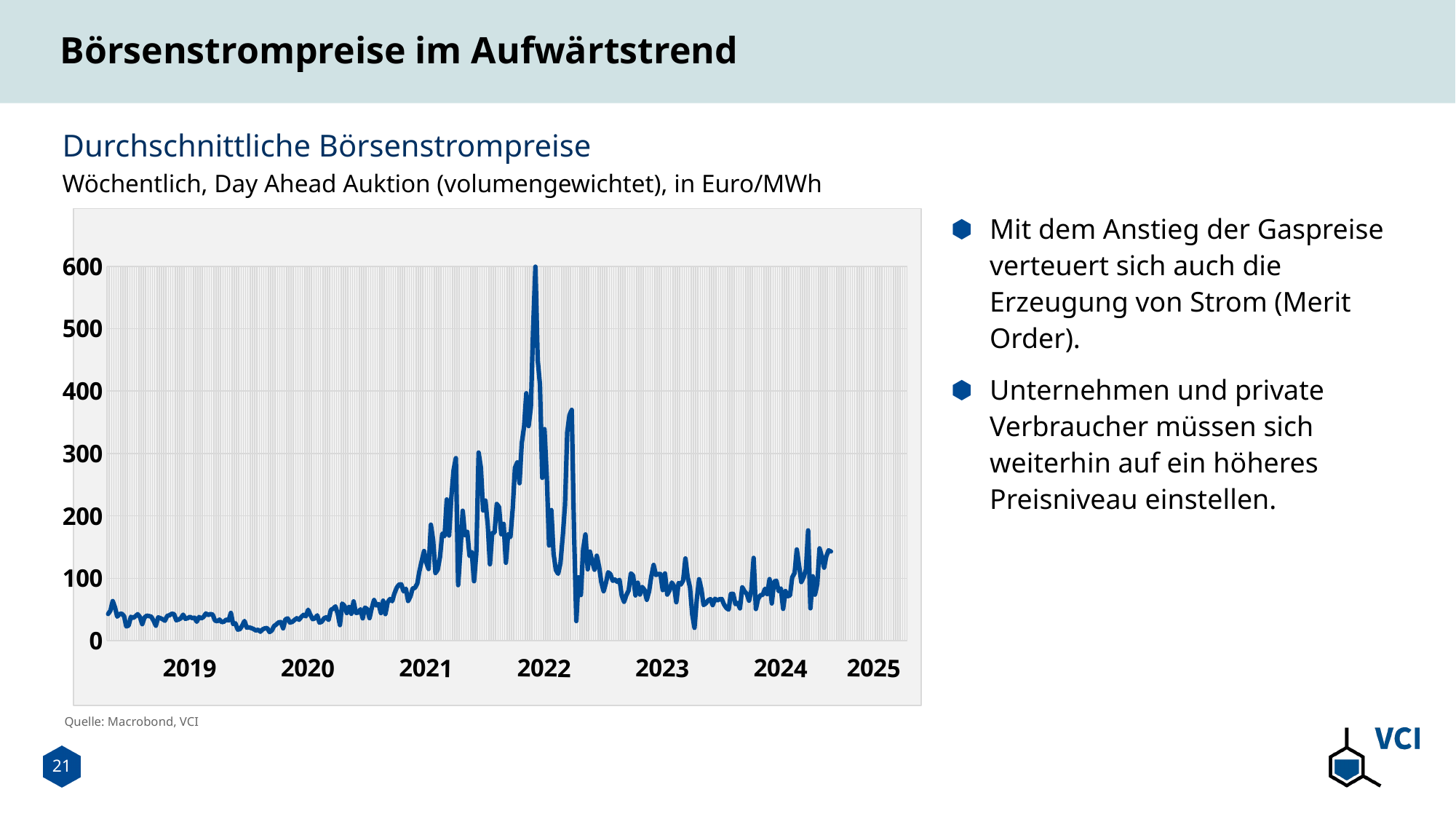
What is the title of the chart? Durchschnittliche Börsenstrompreise Do the values rise or fall from the peak in 2022 to 2023? fall Around which year does the line reach its peak? 2022 Are the values during 2023 greater or less than 200? less Is the highest value of the line greater or less than 500? greater Are the values during 2019 greater or less than 100? less Which period has higher values, 2019 or 2022? 2022 Do the values rise or fall from 2020 to the end of 2021? rise How many year labels are shown on the x axis? 7 What kind of chart is shown on the slide? line chart What is the highest value shown on the y axis? 600 In what unit are the values of the chart given? Euro/MWh